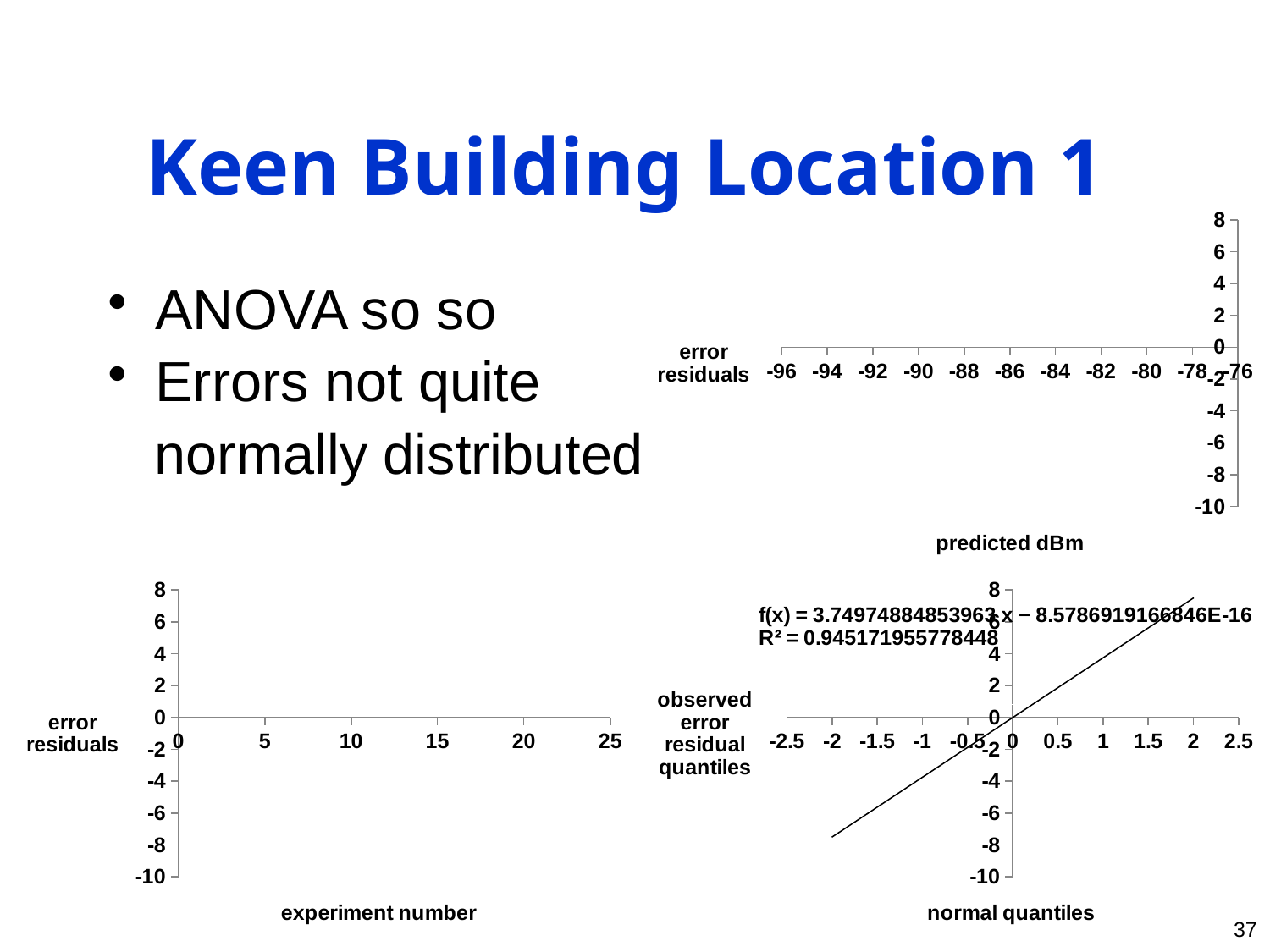
On the bottom-right chart, what is the intercept term in the printed equation f(x)? − 8.5786919166846E-16 On the bottom-right chart, what is the slope coefficient in the printed equation f(x)? 3.74974884853963 What is the x-axis title of the bottom-right chart? normal quantiles On the bottom-right chart, does the fitted line rise or fall as normal quantiles increase? rise On the bottom-right chart, what is the R² value printed on the chart? 0.945171955778448 What is the x-axis title of the top-right chart? predicted dBm How many charts are shown on the slide? 3